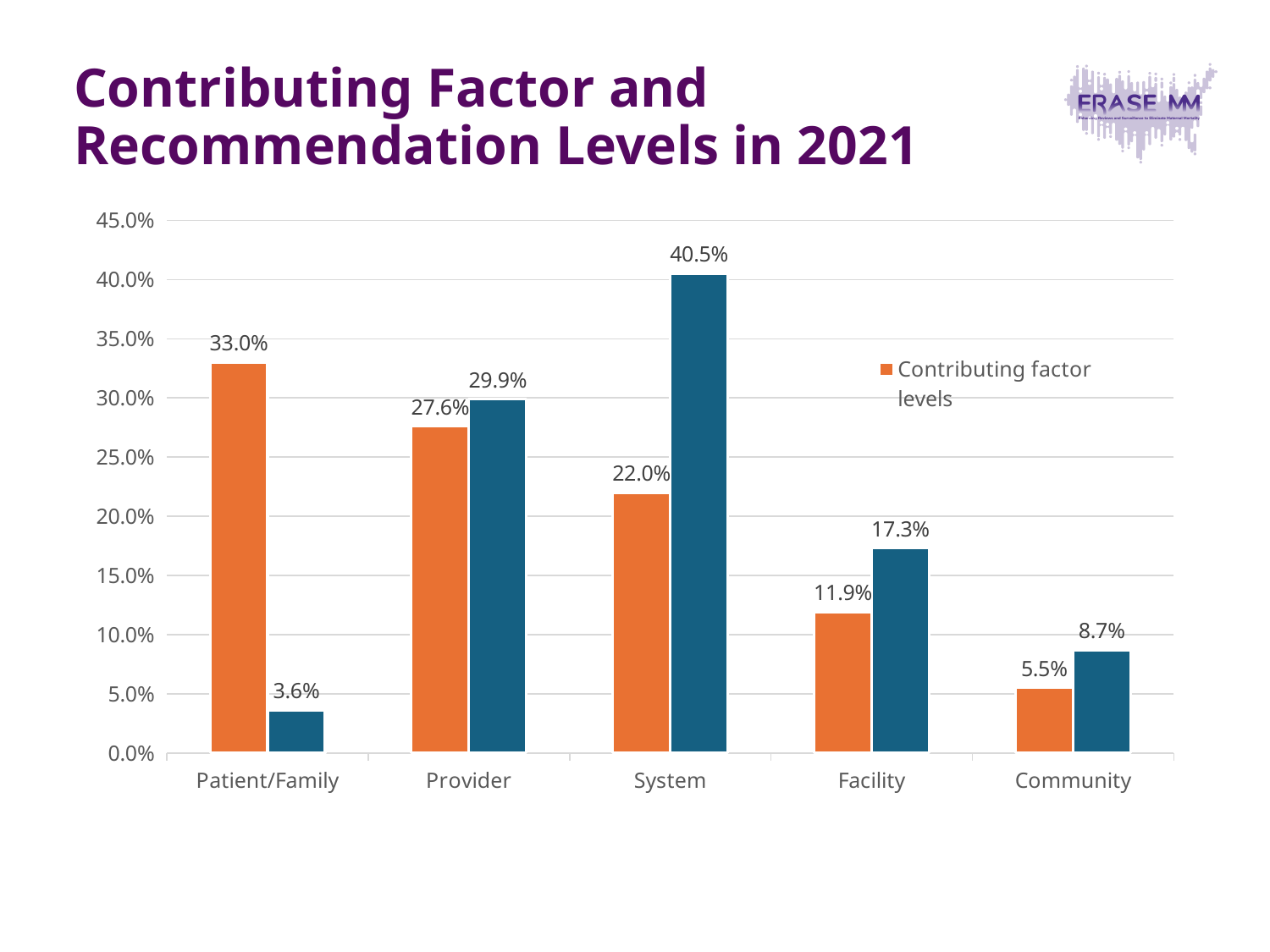
What is the value of the blue bar for System? 40.5% Which category has the highest Contributing factor levels value? Patient/Family Do the Contributing factor levels values rise or fall from Patient/Family to Community? Fall What is the value of the blue bar for Community? 8.7% What kind of chart is shown on the slide? Bar chart How many categories are shown on the x axis? 5 Which category has the lowest value in the blue series? Patient/Family For Provider, which is larger: the Contributing factor levels bar or the blue bar? The blue bar What is the difference between the blue bar and the orange bar for System? 18.5% What is the Contributing factor levels value for Facility? 11.9% How many series does the legend list? 1 What is the Contributing factor levels value for Patient/Family? 33.0%